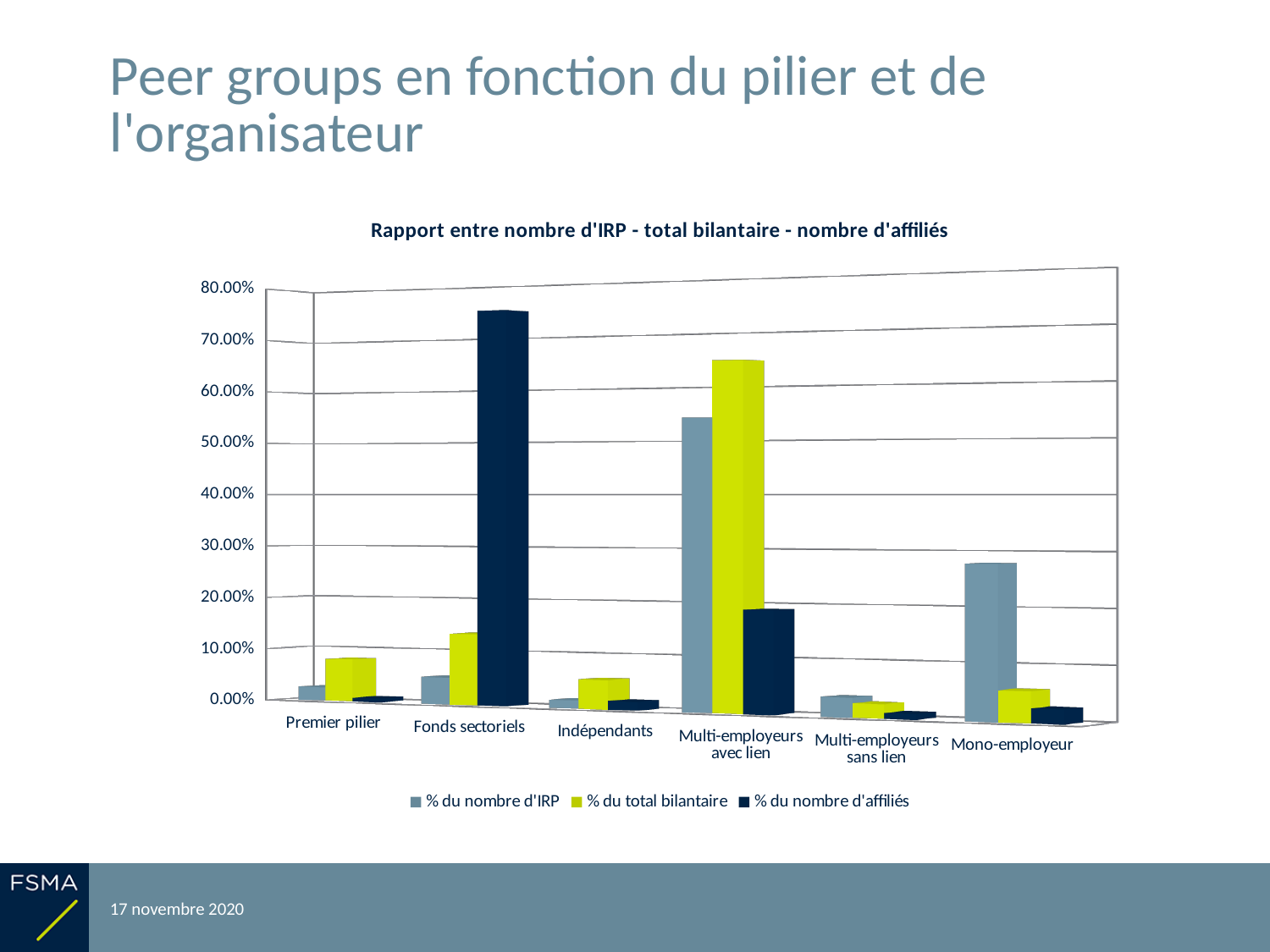
Which category has the highest value for % du nombre d'affiliés? Fonds sectoriels How many series does the chart legend list? 3 For Multi-employeurs avec lien, which is larger: % du nombre d'IRP or % du total bilantaire? % du total bilantaire Is the value of % du nombre d'IRP for Mono-employeur greater or less than 20.00%? greater Which series is shown in dark navy in the chart? % du nombre d'affiliés What is the title of the chart? Rapport entre nombre d'IRP - total bilantaire - nombre d'affiliés What kind of chart is shown on the slide? bar chart Is the value of % du nombre d'affiliés for Fonds sectoriels greater or less than 60.00%? greater Which category has the highest value for % du total bilantaire? Multi-employeurs avec lien Which category has the highest value for % du nombre d'IRP? Multi-employeurs avec lien How many categories are shown on the x axis of the chart? 6 Is the value of % du total bilantaire for Fonds sectoriels greater or less than 20.00%? less